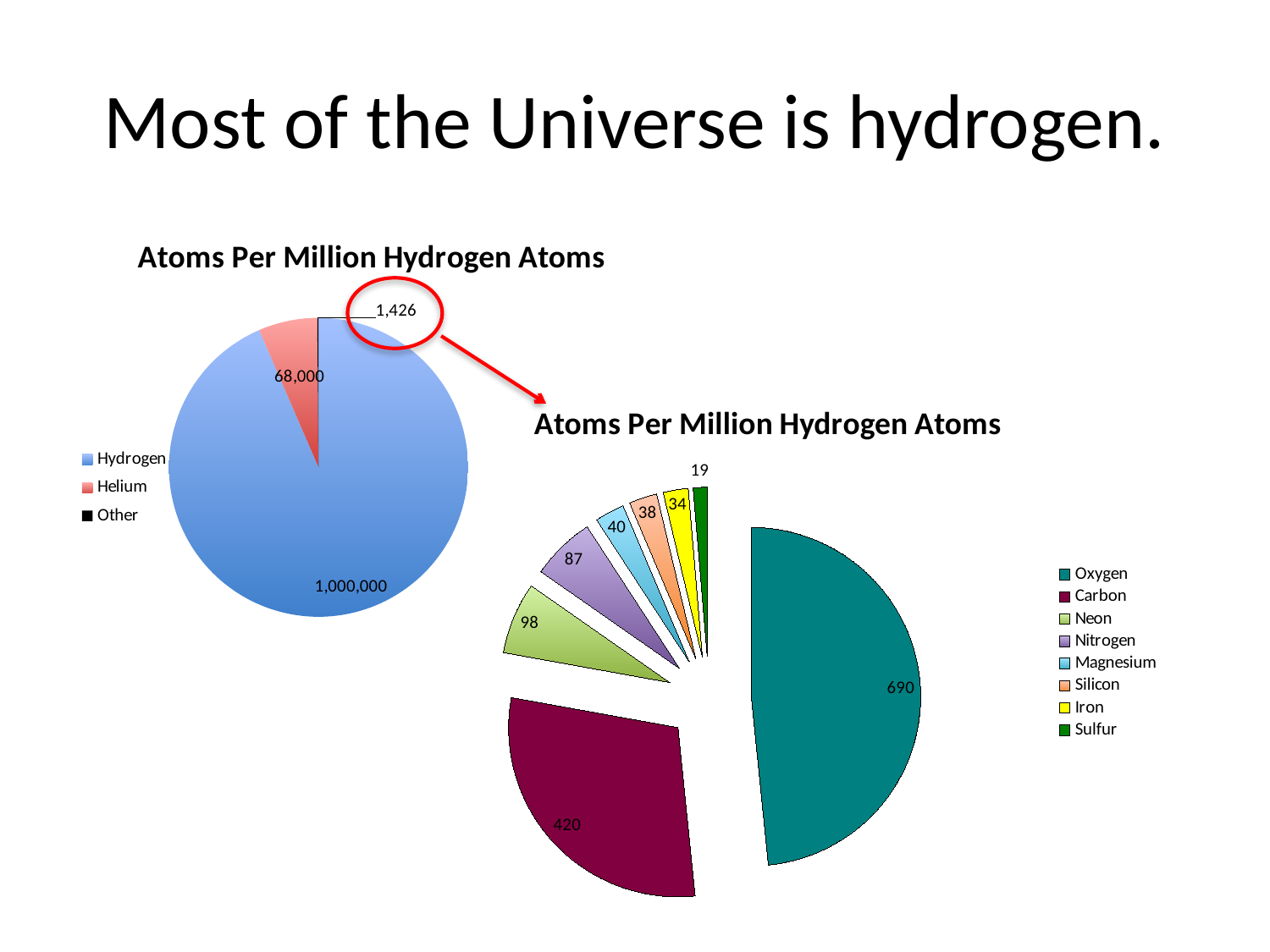
In the upper-left pie chart, how many entries does the legend list? 3 In the lower-right pie chart, how many elements are shown? 8 In the upper-left pie chart, what is the value for Helium? 68,000 In the upper-left pie chart, what is the difference between the Hydrogen and Helium values? 932,000 What type of chart is used on this slide? Pie chart In the lower-right pie chart, which element has the largest value? Oxygen In the upper-left pie chart, what is the value for Other? 1,426 In the upper-left pie chart, what is the value for Hydrogen? 1,000,000 In the lower-right pie chart, which element has the smallest value? Sulfur In the lower-right pie chart, what is the value for Neon? 98 In the lower-right pie chart, what is the difference between the Oxygen and Carbon values? 270 In the lower-right pie chart, what is the value for Oxygen? 690